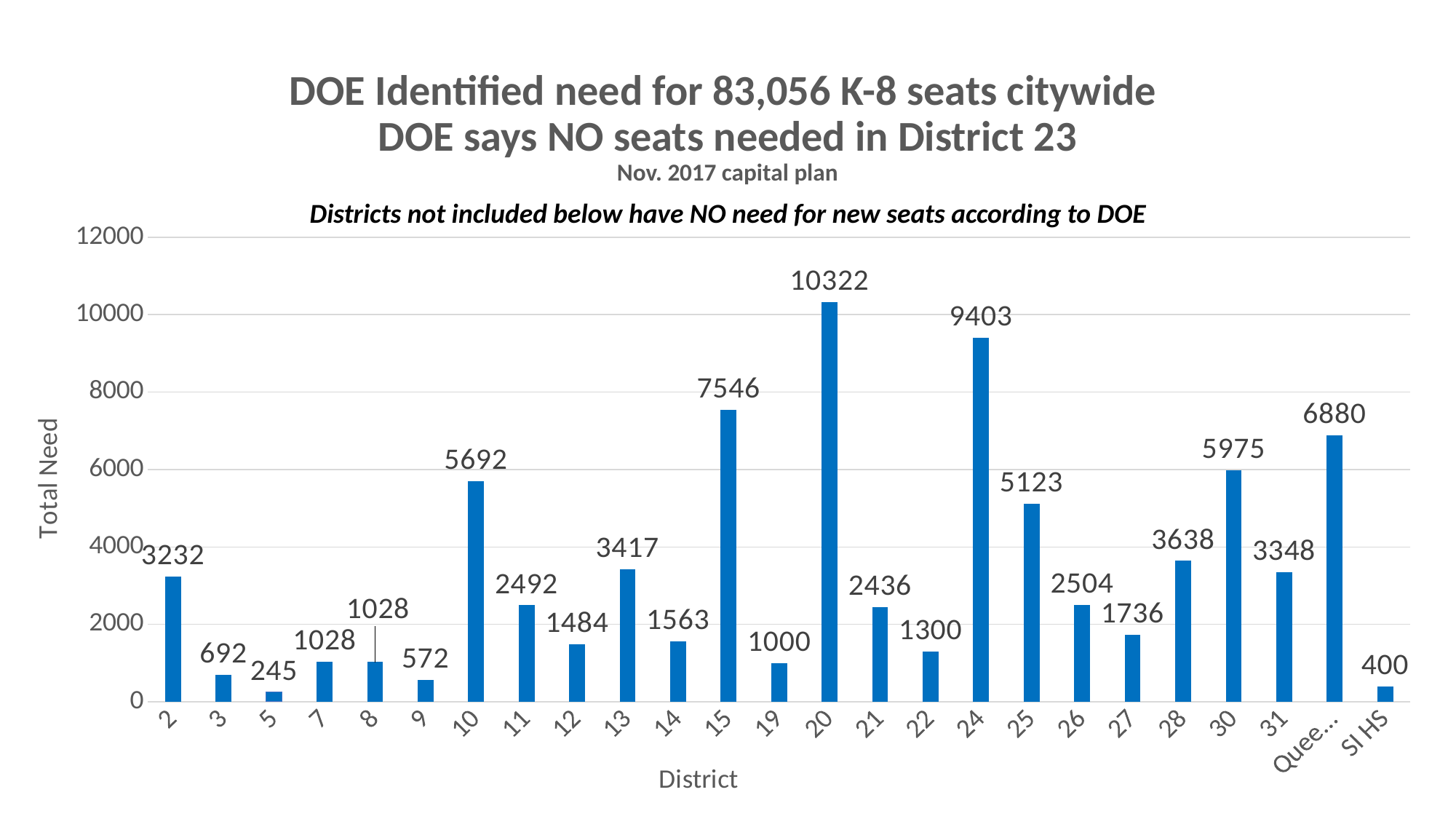
What is the total need for District 15? 7546 What is the total need for District 31? 3348 According to the chart title, how many K-8 seats did DOE identify as needed citywide? 83,056 Which has a larger total need, District 10 or District 30? District 30 What is the total need for SI HS? 400 Which district has the lowest total need? 5 Which district has the highest total need? 20 How many districts are shown on the x axis? 25 What kind of chart is shown on the slide? Bar chart What is the label of the y axis? Total Need What is the difference in total need between District 20 and District 24? 919 What is the total need for District 20? 10322